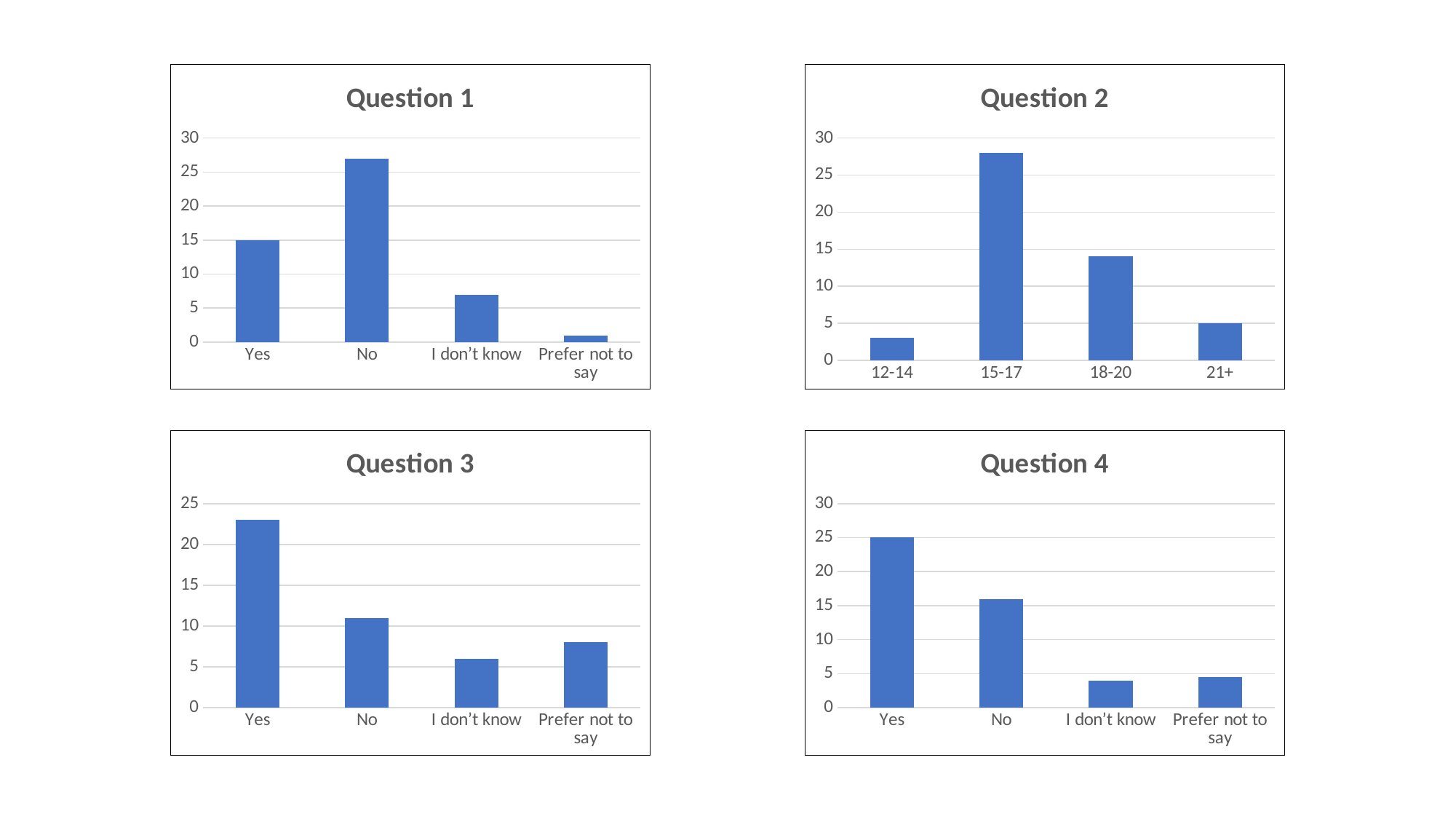
In the Question 2 chart, which age group has the highest value? 15-17 How many categories are shown in the Question 2 chart? 4 In the Question 1 chart, which category has the highest value? No In the Question 2 chart, which age group has the lowest value? 12-14 In the Question 4 chart, what is the value for Yes? 25 In the Question 2 chart, what is the value for 21+? 5 In the Question 1 chart, what is the value for Yes? 15 In the Question 1 chart, is the value for No greater or less than 25? greater In the Question 1 chart, which category has the lowest value? Prefer not to say In the Question 4 chart, which is larger, the value for Yes or the value for No? Yes In the Question 3 chart, which category has the highest value? Yes In the Question 3 chart, is the value for No greater or less than 10? greater